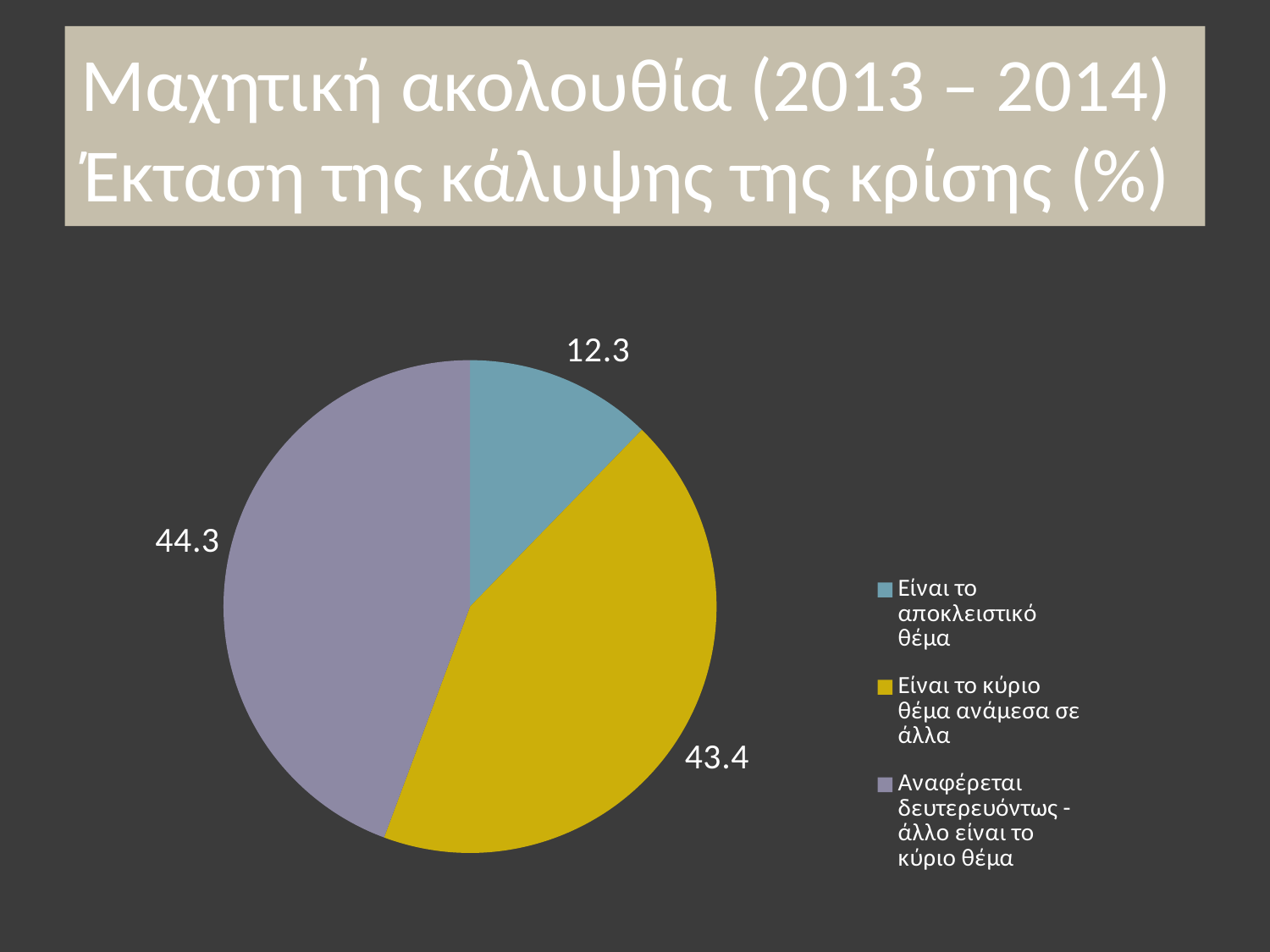
What colour is the slice for "Είναι το κύριο θέμα ανάμεσα σε άλλα"? Yellow What is the value for "Είναι το αποκλειστικό θέμα"? 12.3 What is the title of the chart on the slide? Μαχητική ακολουθία (2013 – 2014) Έκταση της κάλυψης της κρίσης (%) What is the value for "Αναφέρεται δευτερευόντως - άλλο είναι το κύριο θέμα"? 44.3 What is the difference between the values for "Αναφέρεται δευτερευόντως - άλλο είναι το κύριο θέμα" and "Είναι το αποκλειστικό θέμα"? 32.0 How many slices does the pie chart have? 3 Which category has the largest slice? Αναφέρεται δευτερευόντως - άλλο είναι το κύριο θέμα How many entries does the legend list? 3 Which is larger: the value for "Είναι το κύριο θέμα ανάμεσα σε άλλα" or the value for "Είναι το αποκλειστικό θέμα"? Είναι το κύριο θέμα ανάμεσα σε άλλα What is the value for "Είναι το κύριο θέμα ανάμεσα σε άλλα"? 43.4 Which category has the smallest slice? Είναι το αποκλειστικό θέμα What kind of chart is shown on the slide? Pie chart